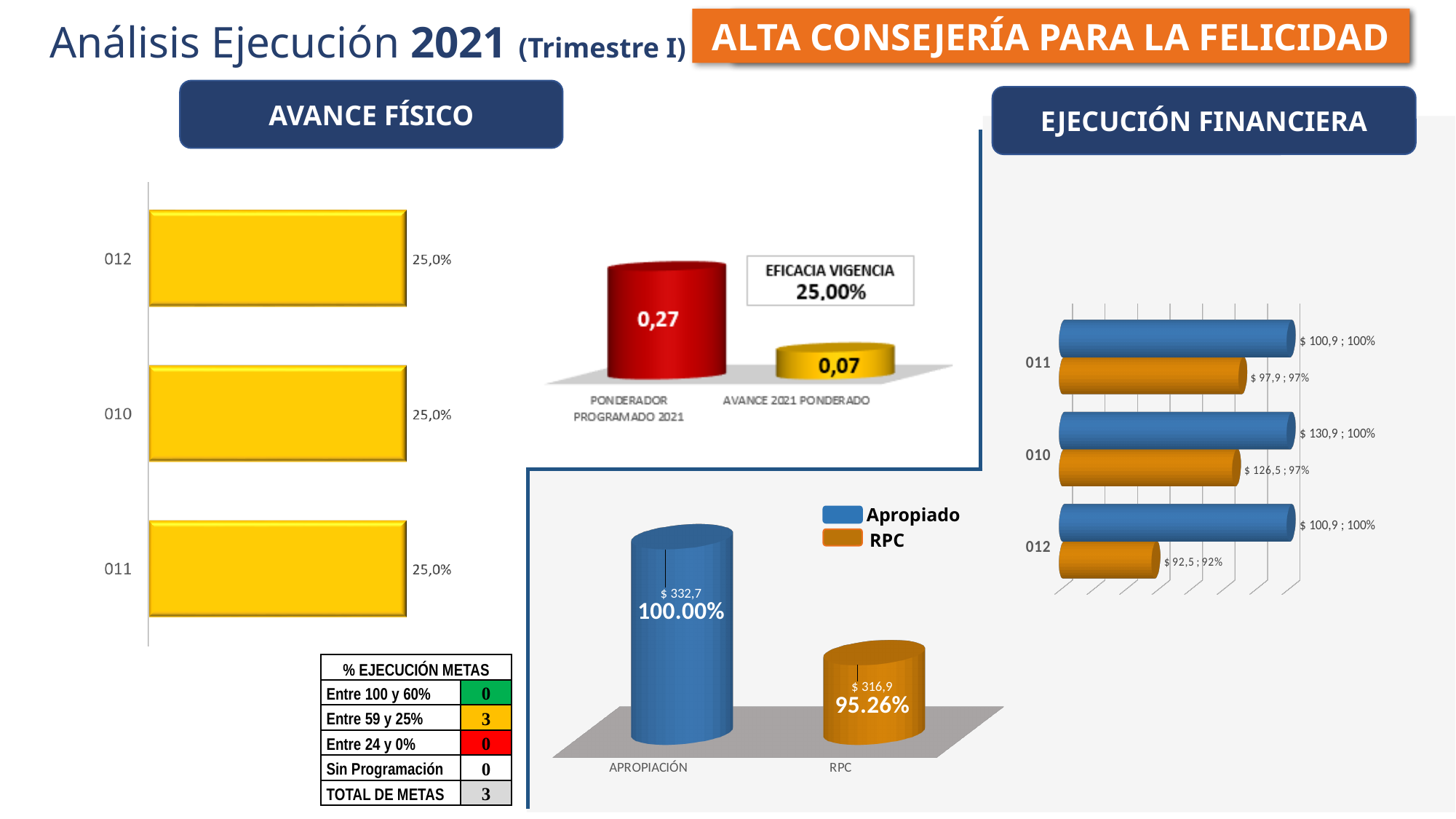
In the yellow bar chart under AVANCE FÍSICO, what is the value for category 010? 25,0% How many categories does the yellow bar chart under AVANCE FÍSICO show? 3 In the chart with PONDERADOR PROGRAMADO 2021 and AVANCE 2021 PONDERADO, what is the value for PONDERADOR PROGRAMADO 2021? 0,27 In the horizontal bar chart under EJECUCIÓN FINANCIERA, what is the RPC label for category 012? $ 92,5 ; 92% How many series does the legend of the bottom chart with APROPIACIÓN and RPC list? 2 In the horizontal bar chart under EJECUCIÓN FINANCIERA, which category has the highest Apropiado value? 010 In the chart with PONDERADOR PROGRAMADO 2021 and AVANCE 2021 PONDERADO, what is the value for AVANCE 2021 PONDERADO? 0,07 In the bottom chart with APROPIACIÓN and RPC, which of the two has the larger value? APROPIACIÓN In the bottom chart with APROPIACIÓN and RPC, what dollar amount is shown for APROPIACIÓN? $ 332,7 In the chart with PONDERADOR PROGRAMADO 2021 and AVANCE 2021 PONDERADO, what is the difference between the two values? 0,20 In the bottom chart with APROPIACIÓN and RPC, what percentage is shown for RPC? 95.26% What kind of chart is the yellow chart under AVANCE FÍSICO? bar chart